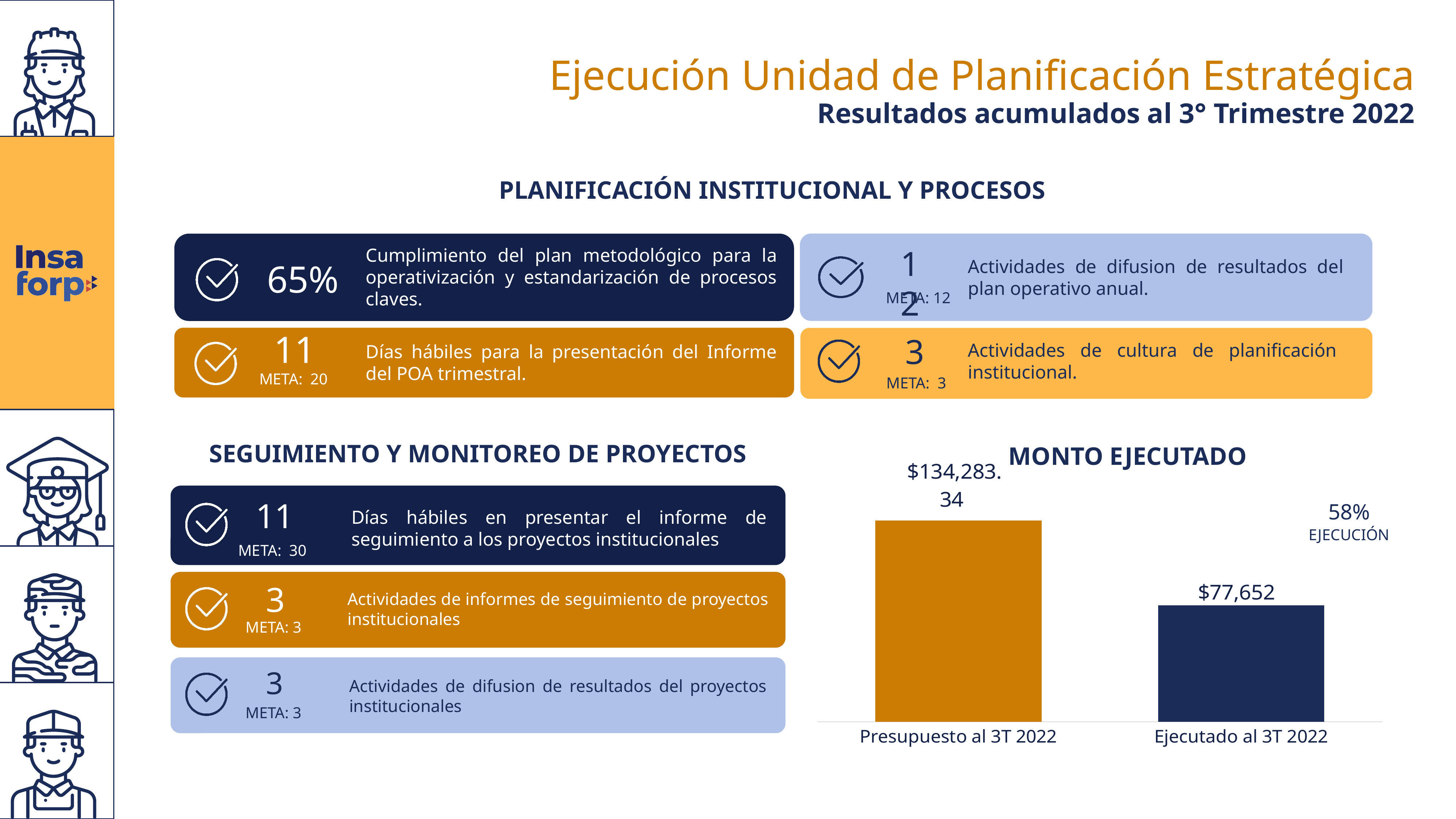
What type of chart is the MONTO EJECUTADO chart? Bar chart How many bars are shown in the MONTO EJECUTADO chart? 2 What is the value of the Presupuesto al 3T 2022 bar in the MONTO EJECUTADO chart? $134,283.34 Which category has the lowest value in the MONTO EJECUTADO chart? Ejecutado al 3T 2022 What execution percentage is shown next to the MONTO EJECUTADO chart? 58% Which category has the highest value in the MONTO EJECUTADO chart? Presupuesto al 3T 2022 In the MONTO EJECUTADO chart, which is larger: Presupuesto al 3T 2022 or Ejecutado al 3T 2022? Presupuesto al 3T 2022 What is the value of the Ejecutado al 3T 2022 bar in the MONTO EJECUTADO chart? $77,652 Do the values in the MONTO EJECUTADO chart rise or fall from left to right? Fall What is the title of the chart on the slide? MONTO EJECUTADO